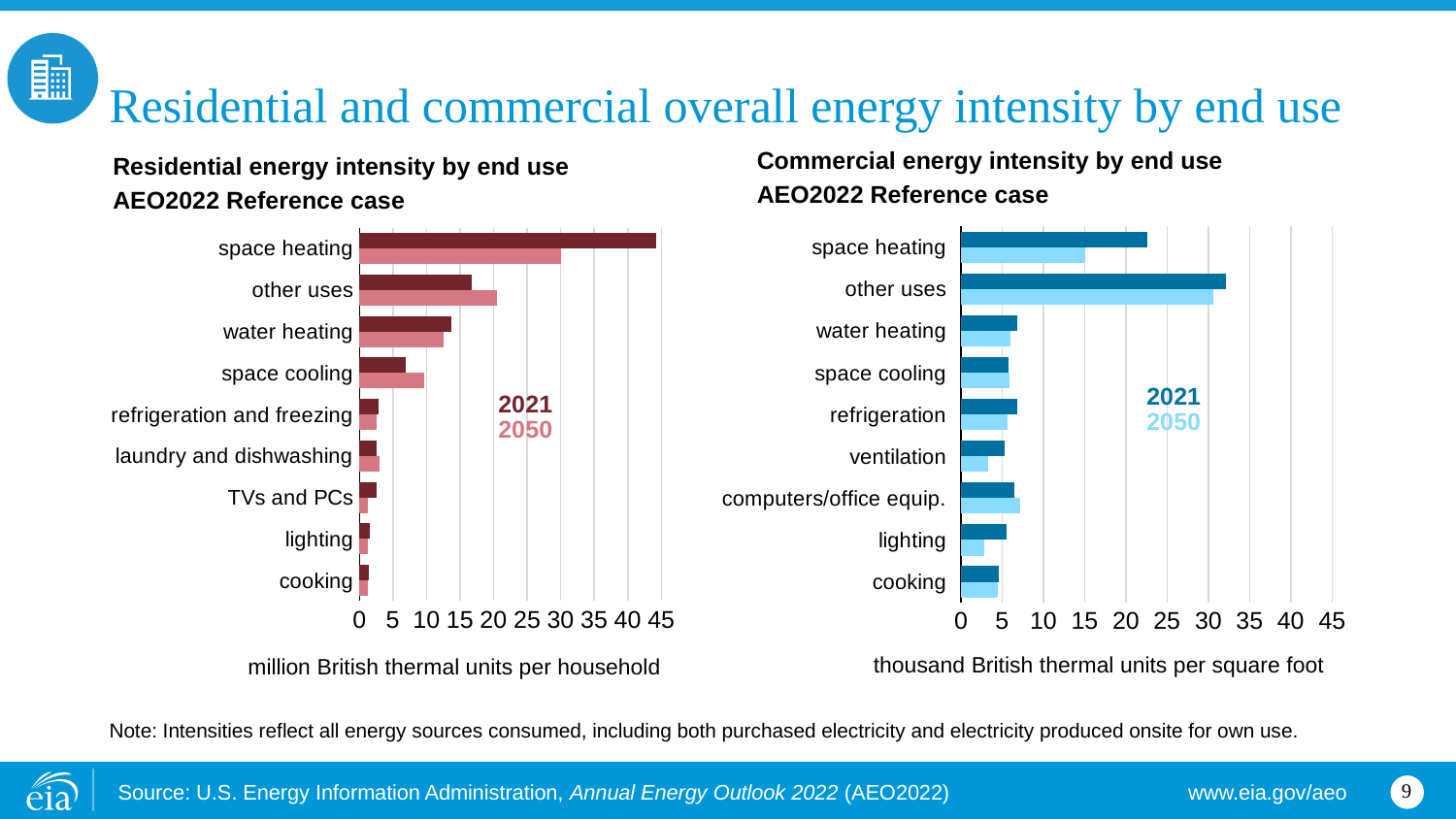
In the commercial energy intensity chart, is the 2021 value for space heating greater or less than 20? greater What kind of chart is the residential energy intensity by end use chart? bar chart What unit is shown on the x axis of the commercial energy intensity chart? thousand British thermal units per square foot In the residential energy intensity chart, which is larger for space heating, the 2021 value or the 2050 value? 2021 In the commercial energy intensity chart, is the 2050 value for lighting greater or less than 5? less In the residential energy intensity chart, is the 2050 value for space heating greater or less than 35? less How many end-use categories are shown in the residential energy intensity chart? 9 How many series does the legend list in the commercial energy intensity chart? 2 In the residential energy intensity chart, which end use has the highest 2021 value? space heating In the commercial energy intensity chart, which end use has the highest 2021 value? other uses In the residential energy intensity chart, which is larger for other uses, the 2021 value or the 2050 value? 2050